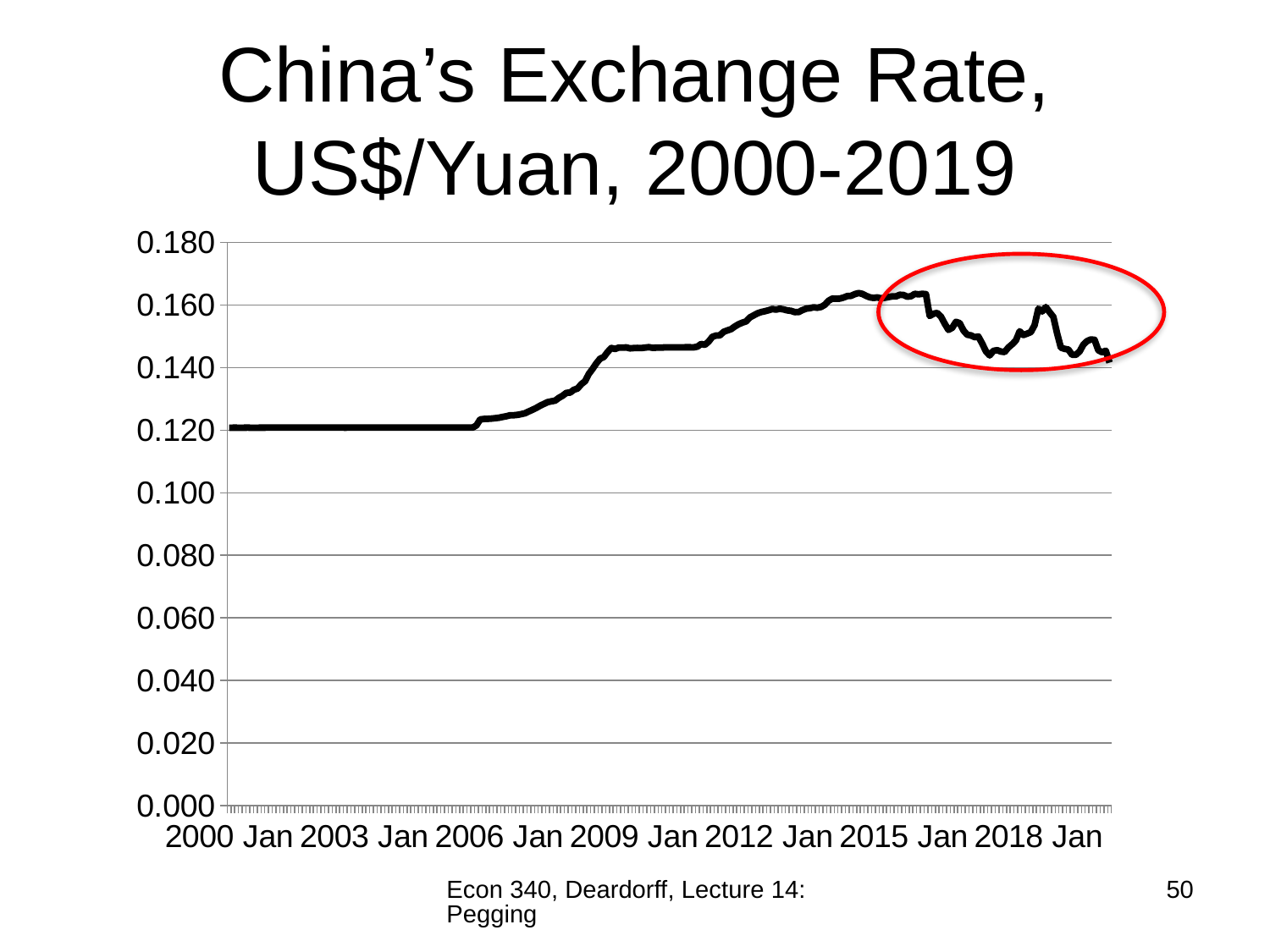
Does the line rise, fall or stay flat between 2000 Jan and 2005? stay flat Which is larger, the value at 2006 Jan or the value at 2018 Jan? 2018 Jan What kind of chart is shown on the slide? line chart Which is larger, the value at 2012 Jan or the value at 2003 Jan? 2012 Jan Is the value at 2009 Jan greater or less than 0.160? less What is the title of the chart? China's Exchange Rate, US$/Yuan, 2000-2019 What colour is the ellipse drawn around the right-hand end of the line? red Is the value at 2000 Jan greater or less than 0.100? greater Is the value at 2018 Jan greater or less than 0.120? greater Does the line rise, fall or stay flat between 2006 Jan and 2009 Jan? rise